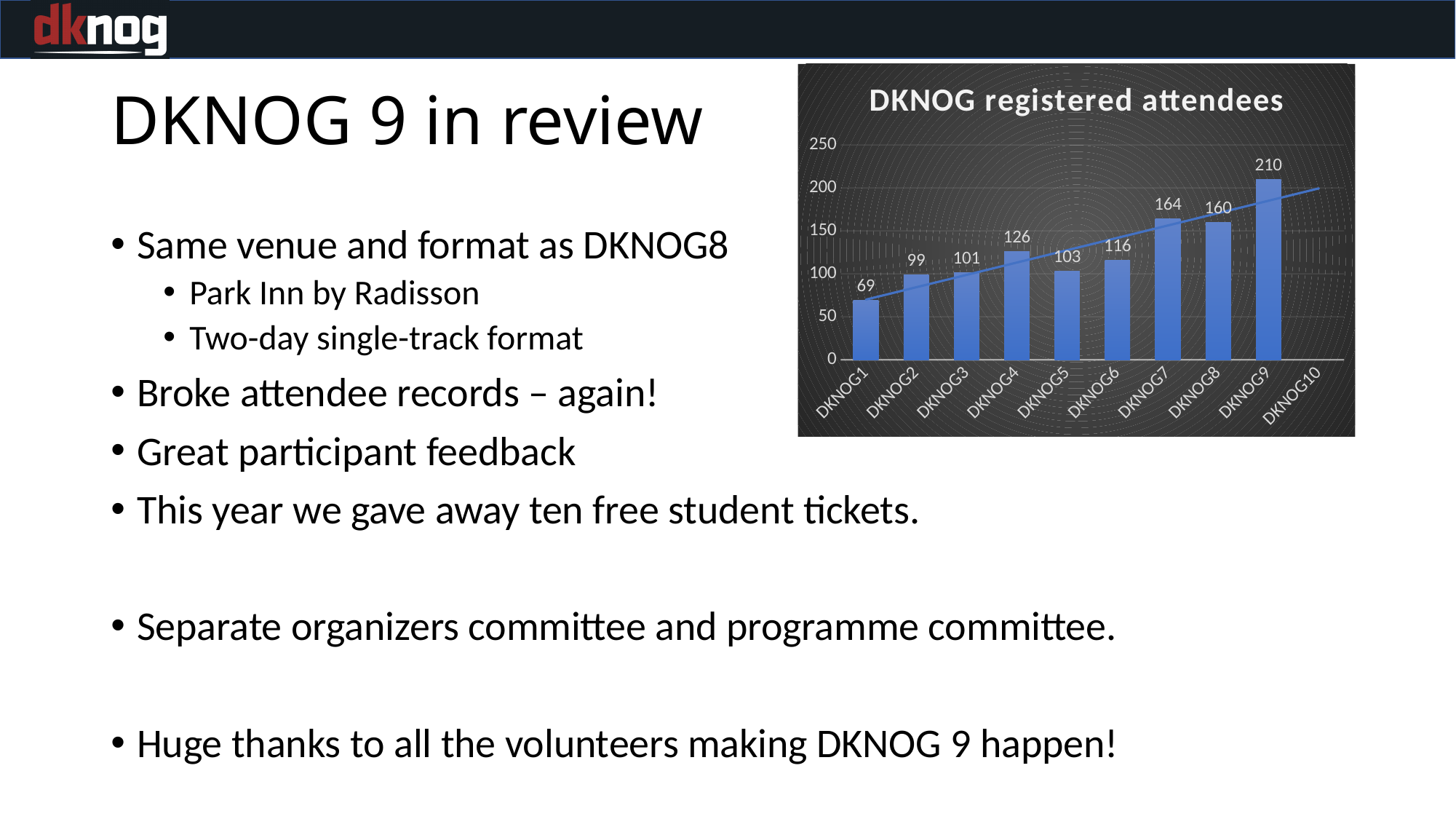
What is the value shown for DKNOG4? 126 What is the value shown for DKNOG1? 69 Do the registered attendee numbers generally rise or fall from DKNOG1 to DKNOG9? rise What type of chart is used to show the registered attendees? bar chart What is the title of the chart? DKNOG registered attendees Which event has the lowest number of registered attendees? DKNOG1 Which had more registered attendees, DKNOG4 or DKNOG5? DKNOG4 What is the difference in registered attendees between DKNOG9 and DKNOG8? 50 How many bars are plotted in the chart? 9 Is the value for DKNOG7 greater or less than 150? greater How many registered attendees are shown for DKNOG9? 210 Which event has the highest number of registered attendees? DKNOG9